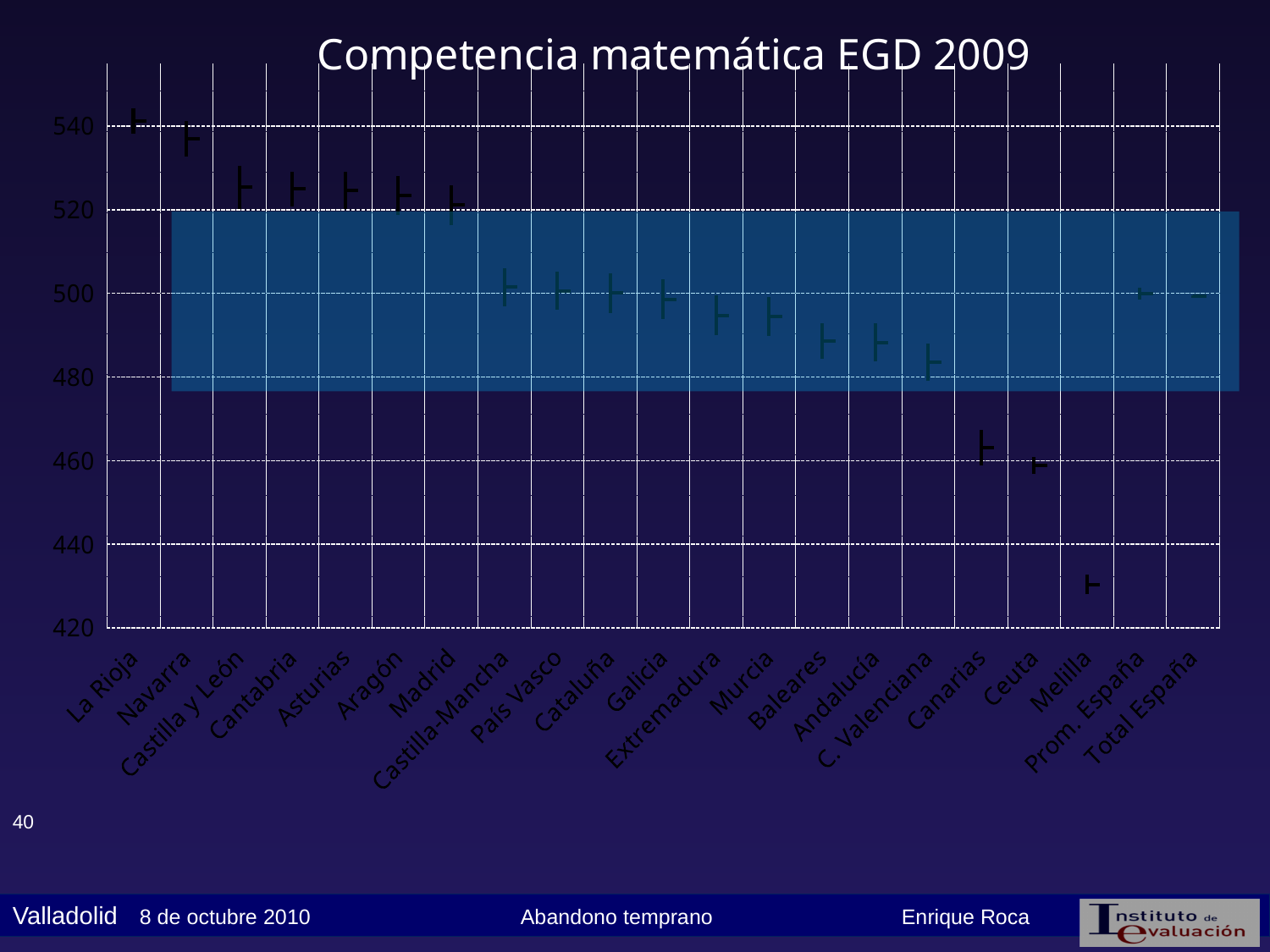
Is the value for La Rioja greater or less than 520? greater Which region has the lowest value on the chart? Melilla Which has the larger value, Navarra or Madrid? Navarra Is the value for Navarra greater or less than 520? greater Which has the larger value, Ceuta or Melilla? Ceuta Is the value for Canarias greater or less than 480? less What is the title of the chart? Competencia matemática EGD 2009 Do the values generally rise or fall moving from left to right across the regions? fall How many categories are shown on the x axis? 21 Which region has the highest value on the chart? La Rioja